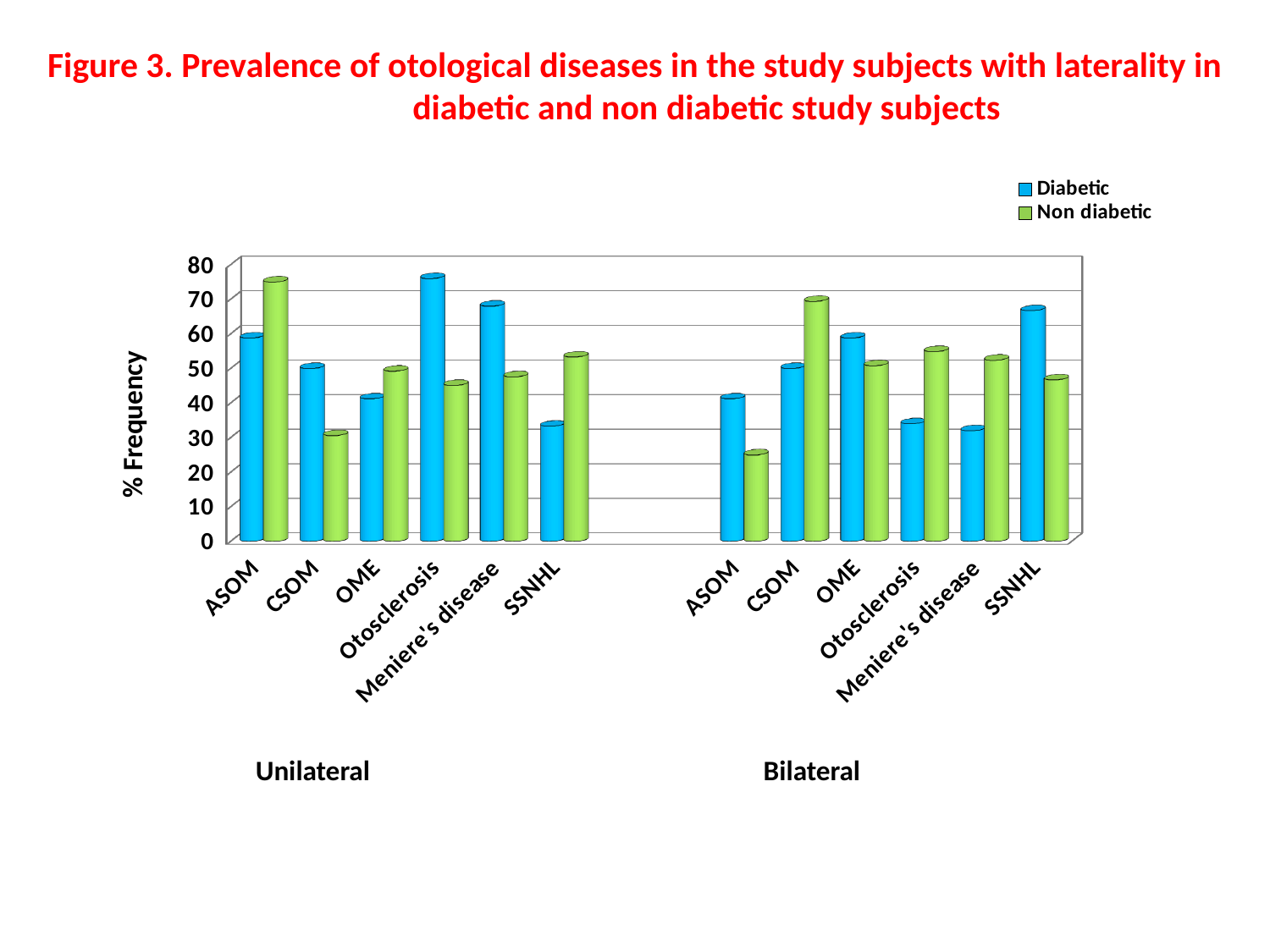
In the Unilateral group, is the Diabetic value for Otosclerosis greater or less than 70? greater What is the label of the vertical axis? % Frequency In the Bilateral group, which is larger for CSOM: Diabetic or Non diabetic? Non diabetic In the Unilateral group, which disease has the lowest Diabetic value? SSNHL How many disease categories are shown in the Unilateral group? 6 What kind of chart is shown on the slide? bar chart In the Unilateral group, which disease has the highest Diabetic value? Otosclerosis In the Bilateral group, which disease has the highest Diabetic value? SSNHL In the Unilateral group, is the Non diabetic value for CSOM greater or less than 40? less How many series does the legend list? 2 In the Bilateral group, is the Non diabetic value for ASOM greater or less than 30? less In the Unilateral group, which is larger for ASOM: Diabetic or Non diabetic? Non diabetic